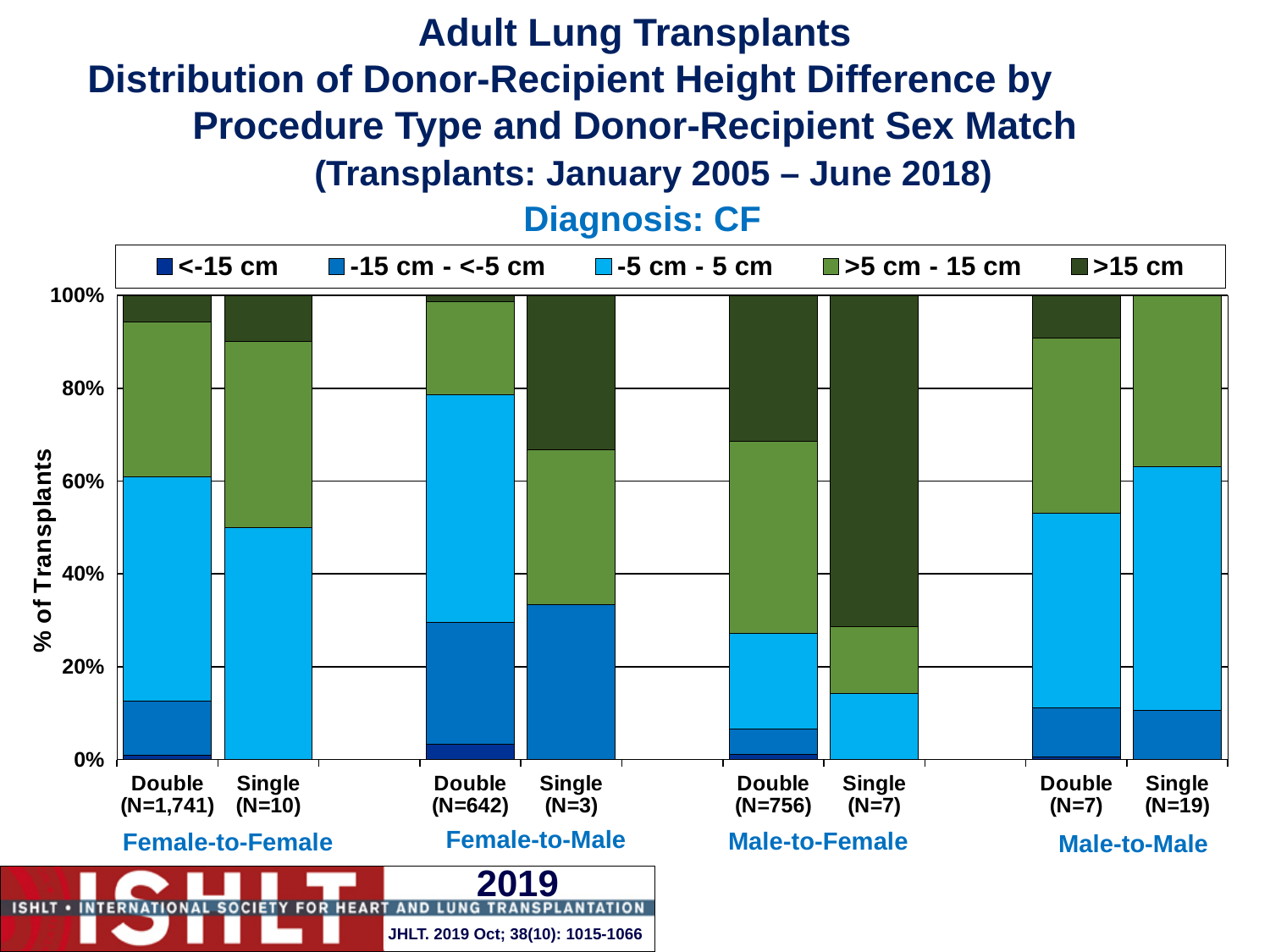
Which has a larger >15 cm share: Female-to-Female Single (N=10) or Male-to-Female Single (N=7)? Male-to-Female Single (N=7) Which has a larger -5 cm - 5 cm share: Male-to-Female Double (N=756) or Male-to-Male Single (N=19)? Male-to-Male Single (N=19) How many series does the legend list? 5 Which bar has the largest >15 cm segment? Male-to-Female Single (N=7) Is the -5 cm - 5 cm share for Male-to-Female Single (N=7) greater or less than 20%? less Is the >15 cm share for Male-to-Female Single (N=7) greater or less than 60%? greater What kind of chart is shown on the slide? Stacked bar chart How many bars are plotted in the chart? 8 What is the N shown for the Female-to-Female Double bar? N=1,741 Is the >15 cm share for Male-to-Female Double (N=756) greater or less than 20%? greater What diagnosis does the chart cover? CF